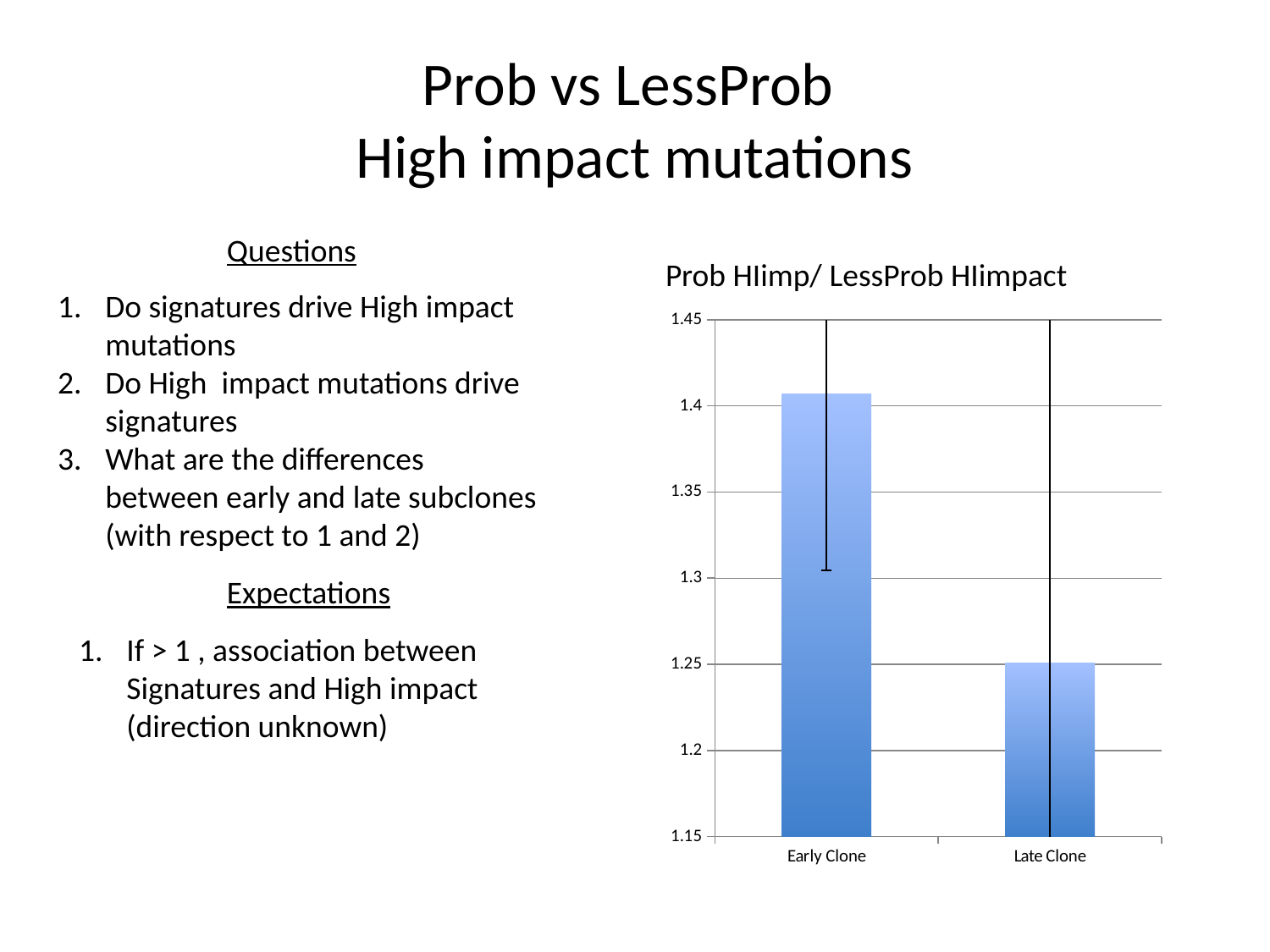
What is the title of the chart? Prob HIimp/ LessProb HIimpact Is the value for Early Clone greater or less than 1.35? greater Which category has the lowest value in the chart? Late Clone How many categories are plotted on the x axis of the chart? 2 Do the bar values rise or fall from Early Clone to Late Clone? fall What is the highest value shown on the chart's y axis? 1.45 What kind of chart is shown on the slide? bar chart Which is larger, the value for Early Clone or the value for Late Clone? Early Clone Is the value for Late Clone greater or less than 1.3? less Is the value for Late Clone greater or less than 1.2? greater Which category has the highest value in the chart? Early Clone